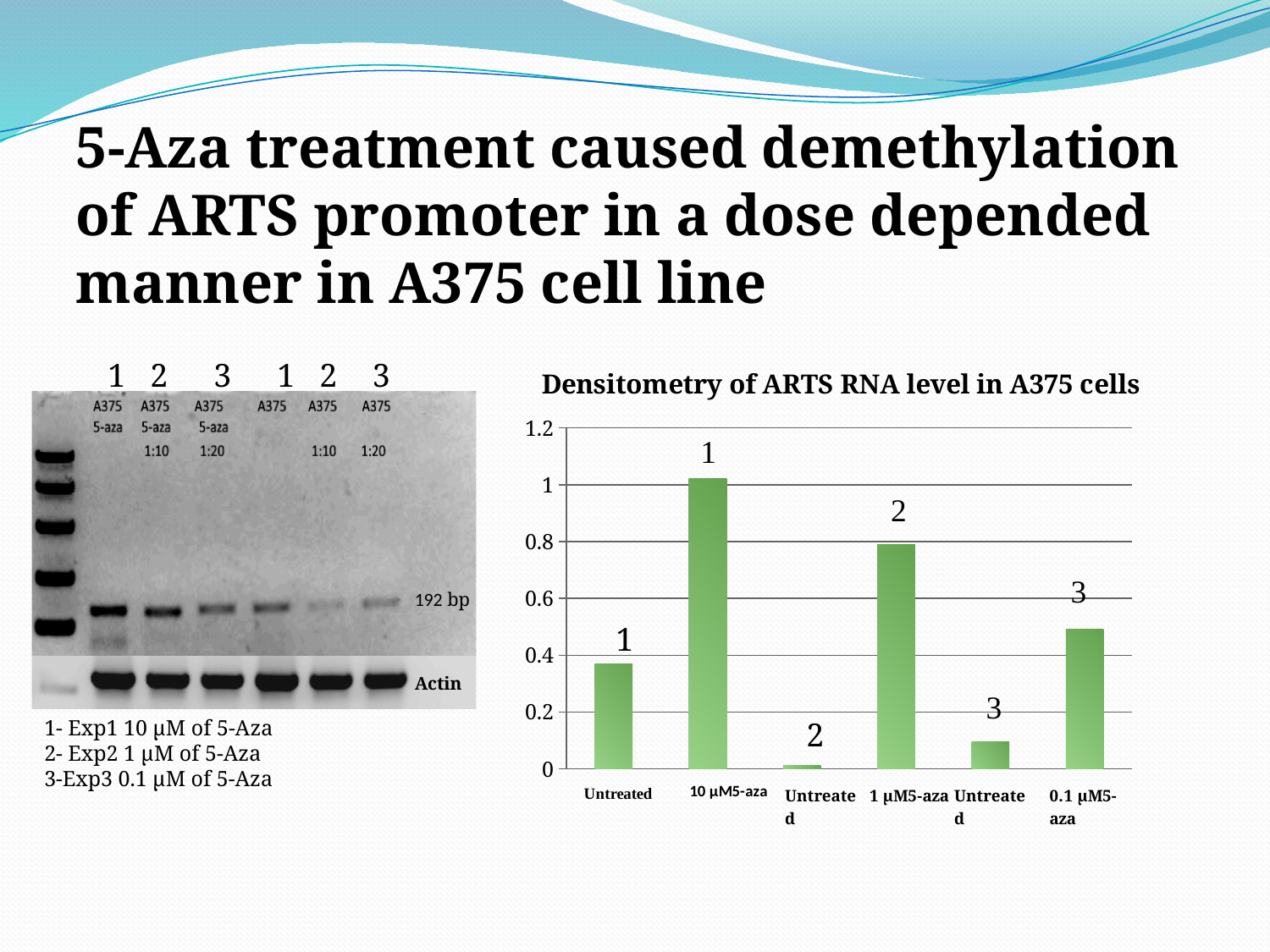
Which bar is the lowest in the chart? the second Untreated bar (next to 10 µM5-aza) Is the value for the first Untreated bar (leftmost) greater or less than 0.2? greater Is the value for 10 µM5-aza greater or less than 0.8? greater What is the title of the chart on the slide? Densitometry of ARTS RNA level in A375 cells Which is larger, the value for 1 µM5-aza or the value for 0.1 µM5-aza? 1 µM5-aza Which category has the highest bar in the chart? 10 µM5-aza Is the value for the third Untreated bar (next to 0.1 µM5-aza) greater or less than 0.2? less Which is larger, the value for 10 µM5-aza or the value for 1 µM5-aza? 10 µM5-aza What kind of chart is shown on the slide? bar chart How many bars are plotted in the chart? 6